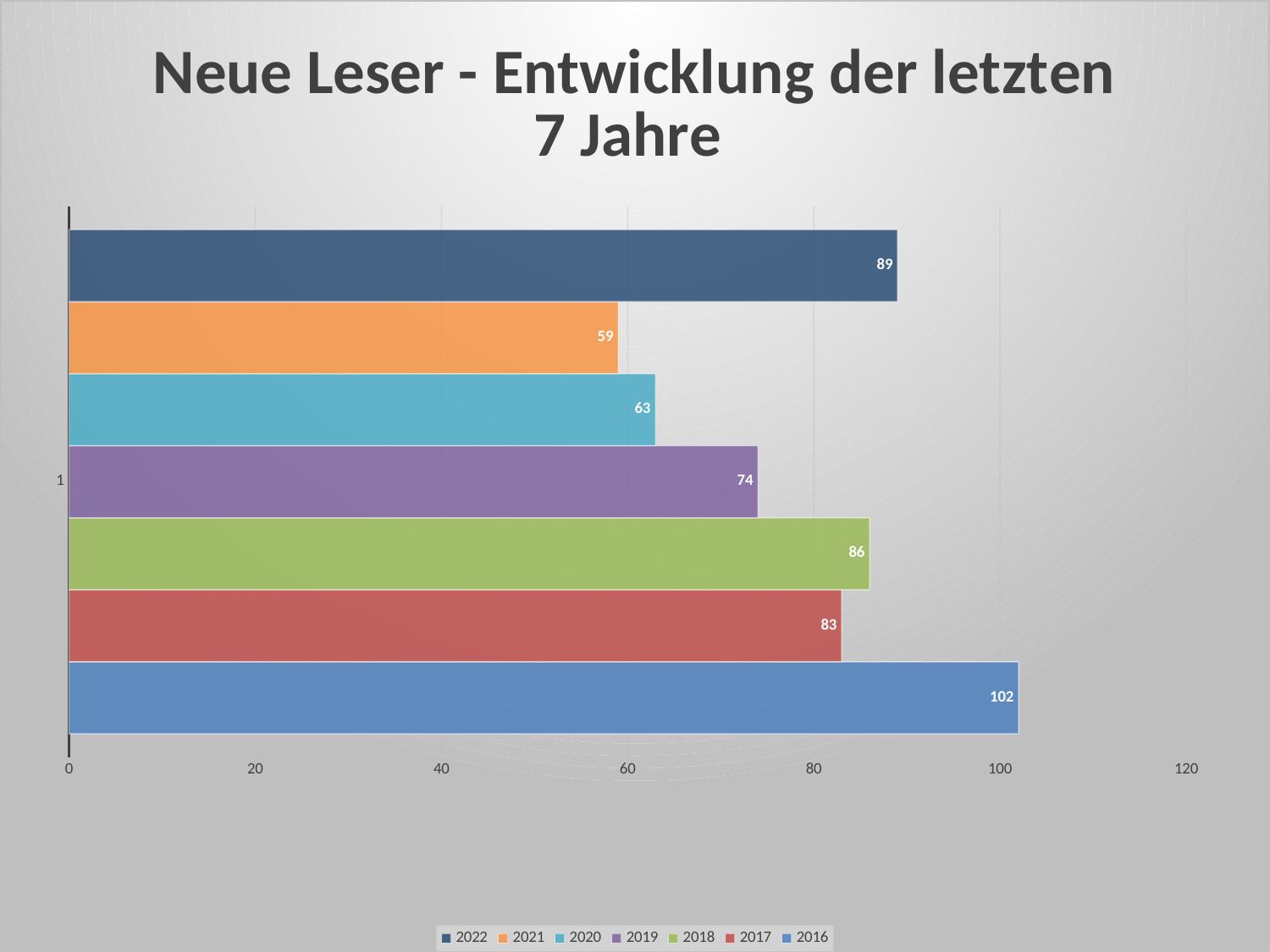
Which year has the lowest value? 2021 What is the difference between the values for 2016 and 2022? 13 What is the value for 2021? 59 What kind of chart is shown on the slide? bar chart What is the value for 2016? 102 Which year has the highest value? 2016 What is the value for 2022? 89 What is the value for 2019? 74 What is the difference between the values for 2018 and 2017? 3 What is the title of the chart? Neue Leser - Entwicklung der letzten 7 Jahre How many series does the legend list? 7 Which is larger, the value for 2020 or the value for 2019? 2019